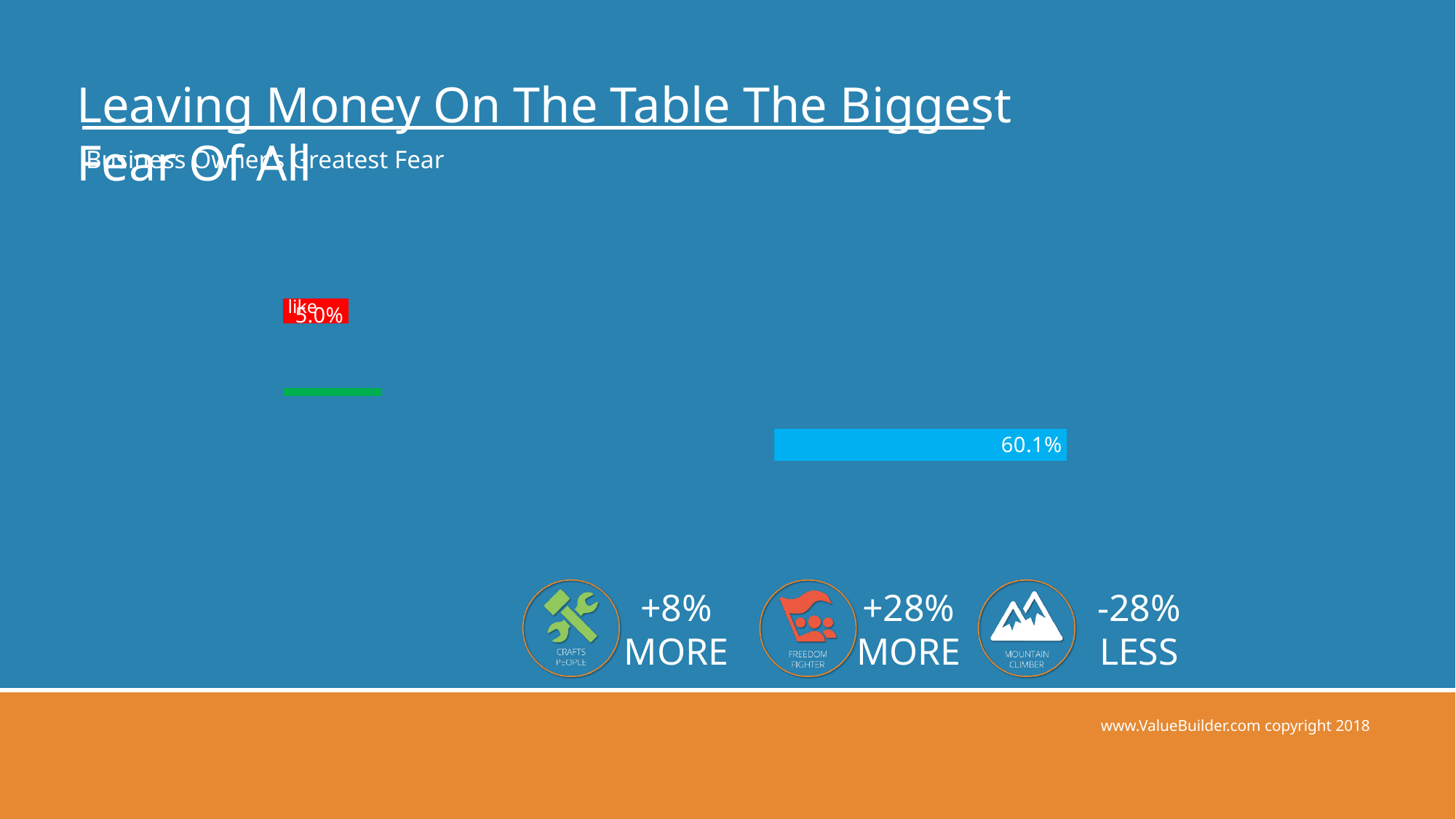
Which is larger, the value on the blue bar or the value on the red bar? the blue bar Which bar has the highest value in the chart? the blue bar (60.1%) What value is printed on the blue bar of the chart? 60.1% What kind of chart is shown on the slide? bar chart How many bars are plotted in the chart? 3 What is the difference between the value on the blue bar (60.1%) and the value on the red bar (5.0%)? 55.1% What value is printed on the red bar of the chart? 5.0%